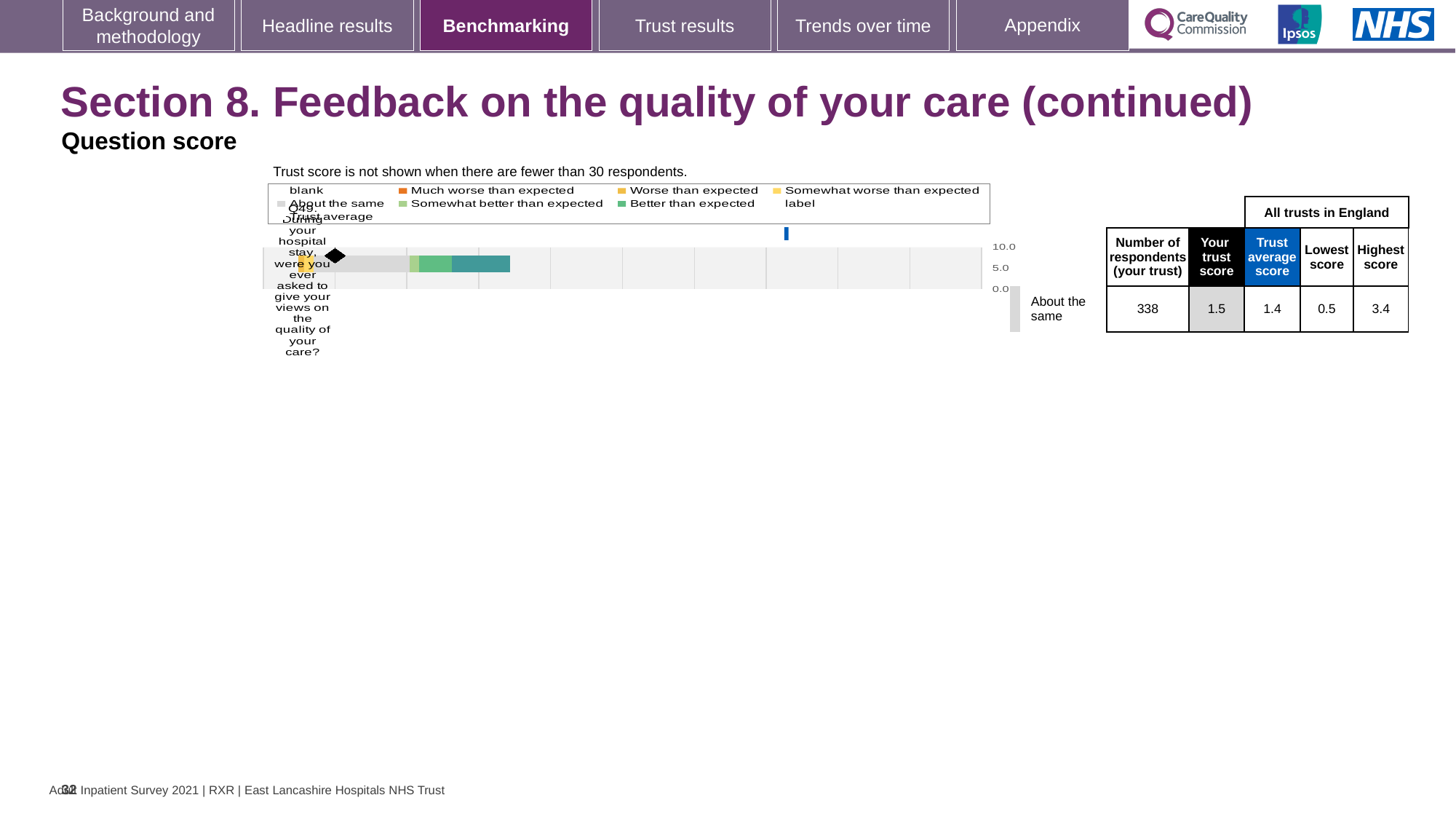
What is the trust average score for Q49? 1.4 What is the difference between the highest and lowest scores for Q49 across all trusts in England? 2.9 How many questions are plotted in the benchmarking chart? 1 What is the number of respondents for Q49 at your trust? 338 What colour does the legend use for 'Much worse than expected'? Orange What kind of chart is used to show the benchmarking for Q49? Bar chart What does the note above the chart say about when the trust score is not shown? When there are fewer than 30 respondents What is the lowest score among all trusts in England for Q49? 0.5 What is your trust score for Q49? 1.5 Which is larger for Q49: your trust score or the trust average score? Your trust score Which benchmark category is the trust's score for Q49 placed in? About the same What is the highest score among all trusts in England for Q49? 3.4